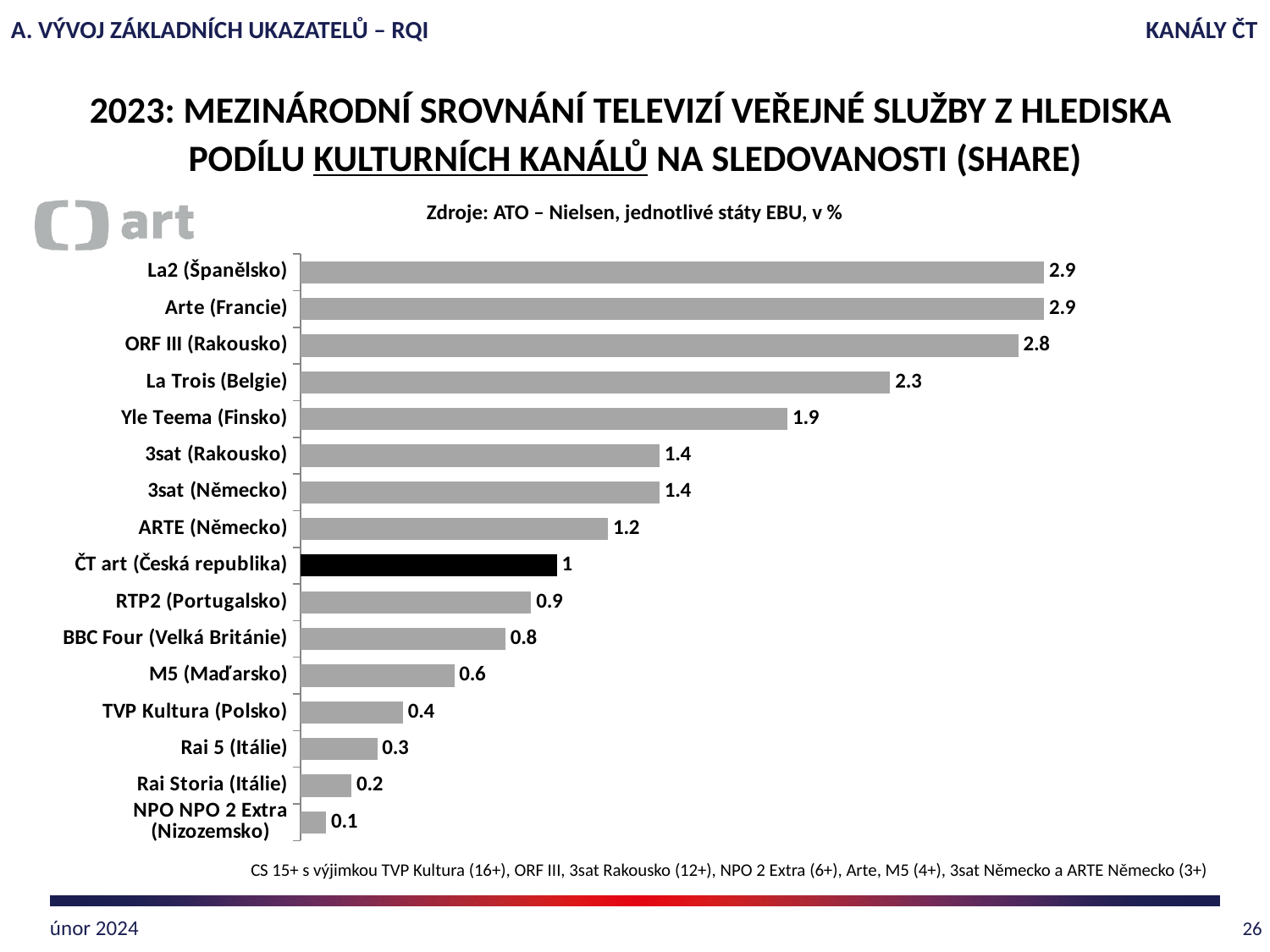
What is the value for Yle Teema (Finsko)? 1.9 What is the value for BBC Four (Velká Británie)? 0.8 Which category has the lowest value? NPO NPO 2 Extra (Nizozemsko) What is the value for ČT art (Česká republika)? 1 What is the difference between the values for La Trois (Belgie) and RTP2 (Portugalsko)? 1.4 Which is larger, the value for M5 (Maďarsko) or the value for TVP Kultura (Polsko)? M5 (Maďarsko) How many categories are shown in the chart? 16 What is the difference between the values for ORF III (Rakousko) and ČT art (Česká republika)? 1.8 What kind of chart is shown on the slide? bar chart Which bar is drawn in black rather than grey? ČT art (Česká republika) What is the value for ORF III (Rakousko)? 2.8 Which is larger, the value for La Trois (Belgie) or the value for Yle Teema (Finsko)? La Trois (Belgie)